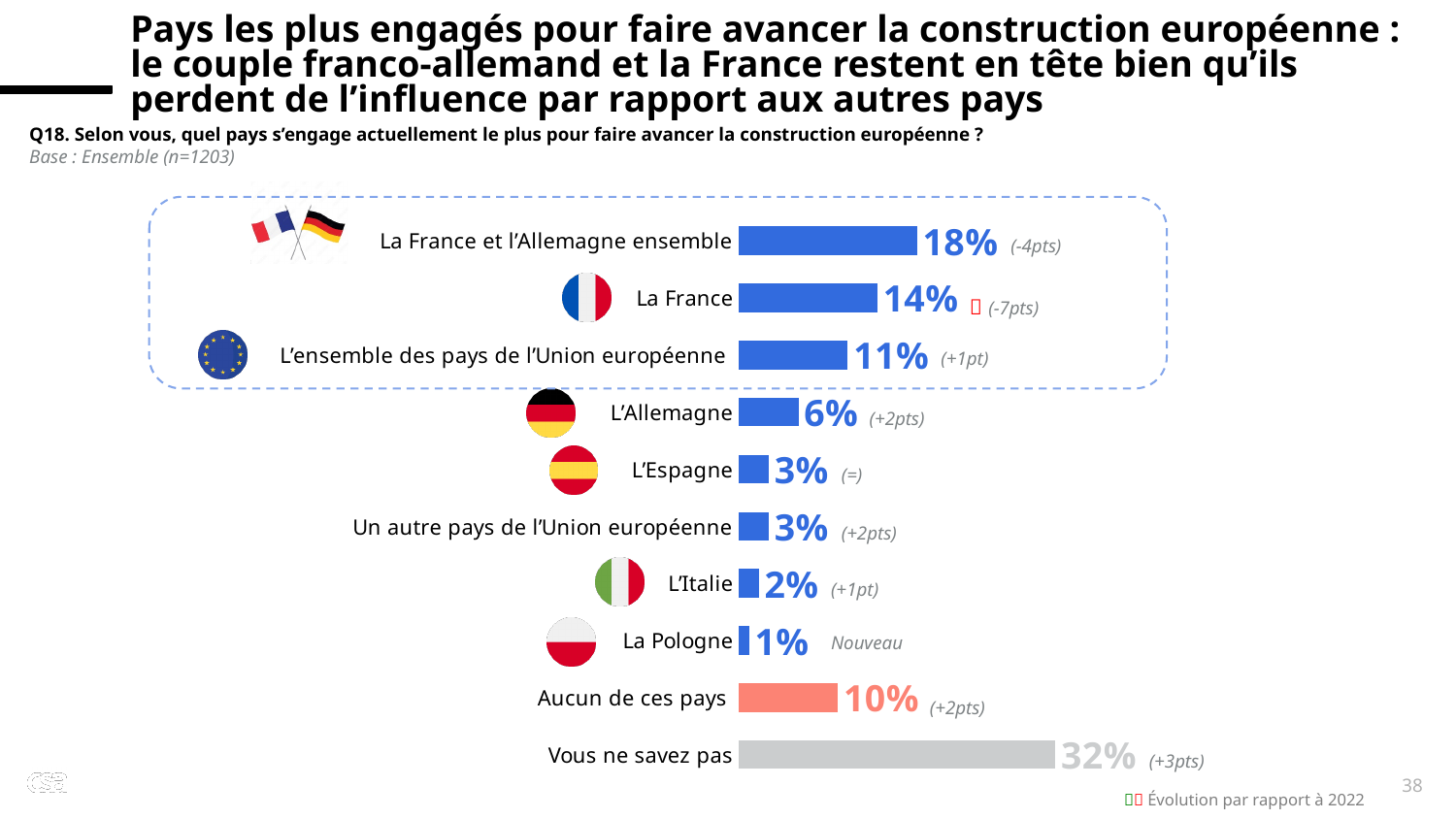
How many categories are shown on the chart? 10 What percentage is shown for "Aucun de ces pays"? 10% What percentage is shown for "La France"? 14% What percentage is shown for "L'ensemble des pays de l'Union européenne"? 11% What percentage is shown for "La France et l'Allemagne ensemble"? 18% Which category has the highest percentage on the chart? Vous ne savez pas What percentage is shown for "Vous ne savez pas"? 32% What kind of chart is shown on the slide? Bar chart Which has a higher percentage, "L'Allemagne" or "L'Espagne"? L'Allemagne Which category has the lowest percentage on the chart? La Pologne What is the difference in percentage points between "La France et l'Allemagne ensemble" and "La France"? 4 What change compared to 2022 is indicated next to "La France"? -7pts